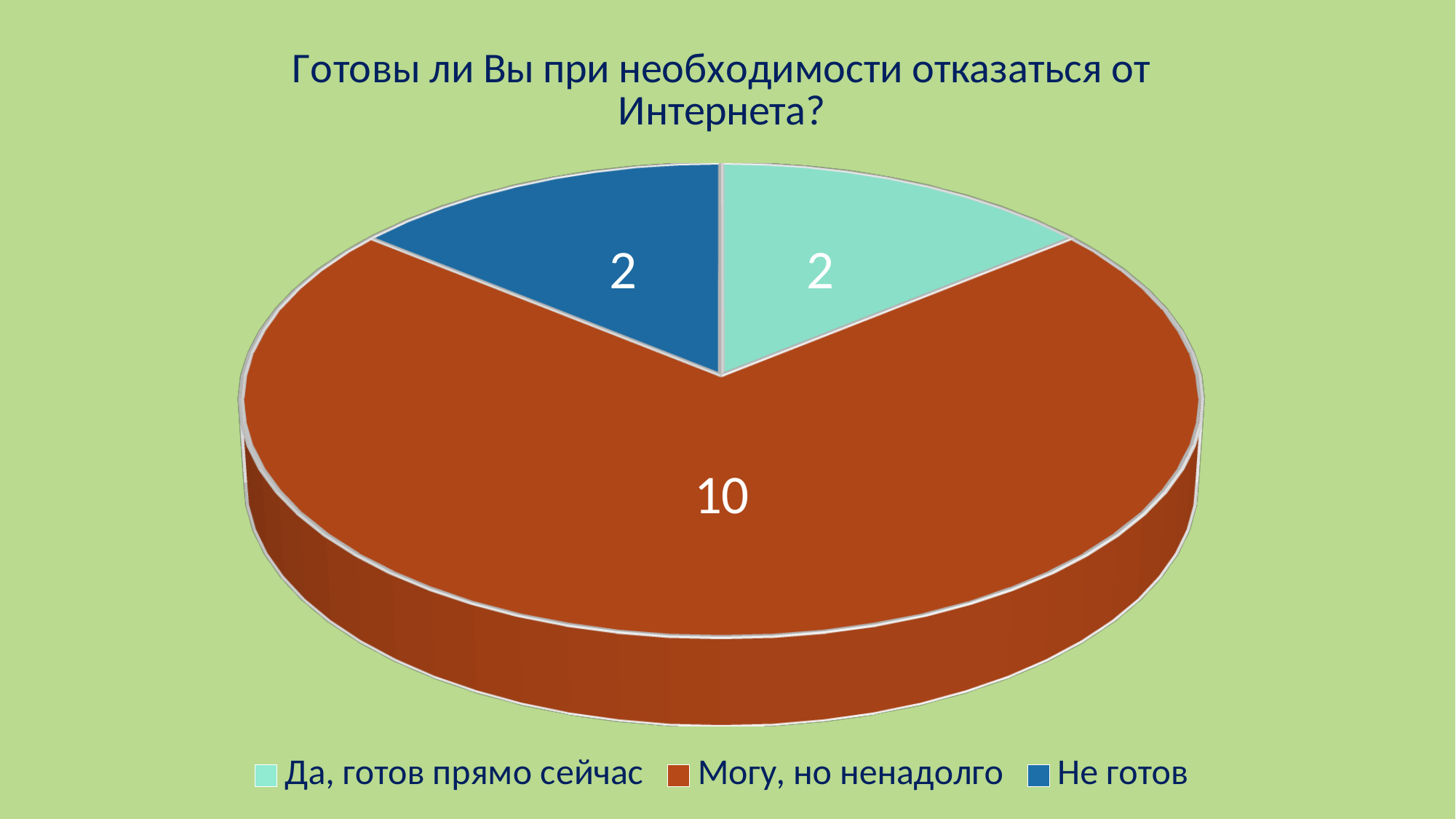
Which is larger: the value for "Могу, но ненадолго" or the value for "Да, готов прямо сейчас"? Могу, но ненадолго How many slices does the pie chart have? 3 What is the total of all the values shown in the pie chart? 14 Which colour represents "Не готов" in the legend? Blue What is the difference between the values for "Могу, но ненадолго" and "Не готов"? 8 What kind of chart is shown on the slide? Pie chart What value is shown for the slice "Могу, но ненадолго"? 10 Which category has the largest slice of the pie? Могу, но ненадолго What value is shown for the slice "Да, готов прямо сейчас"? 2 How many entries does the legend list? 3 What value is shown for the slice "Не готов"? 2 What is the title of the chart? Готовы ли Вы при необходимости отказаться от Интернета?